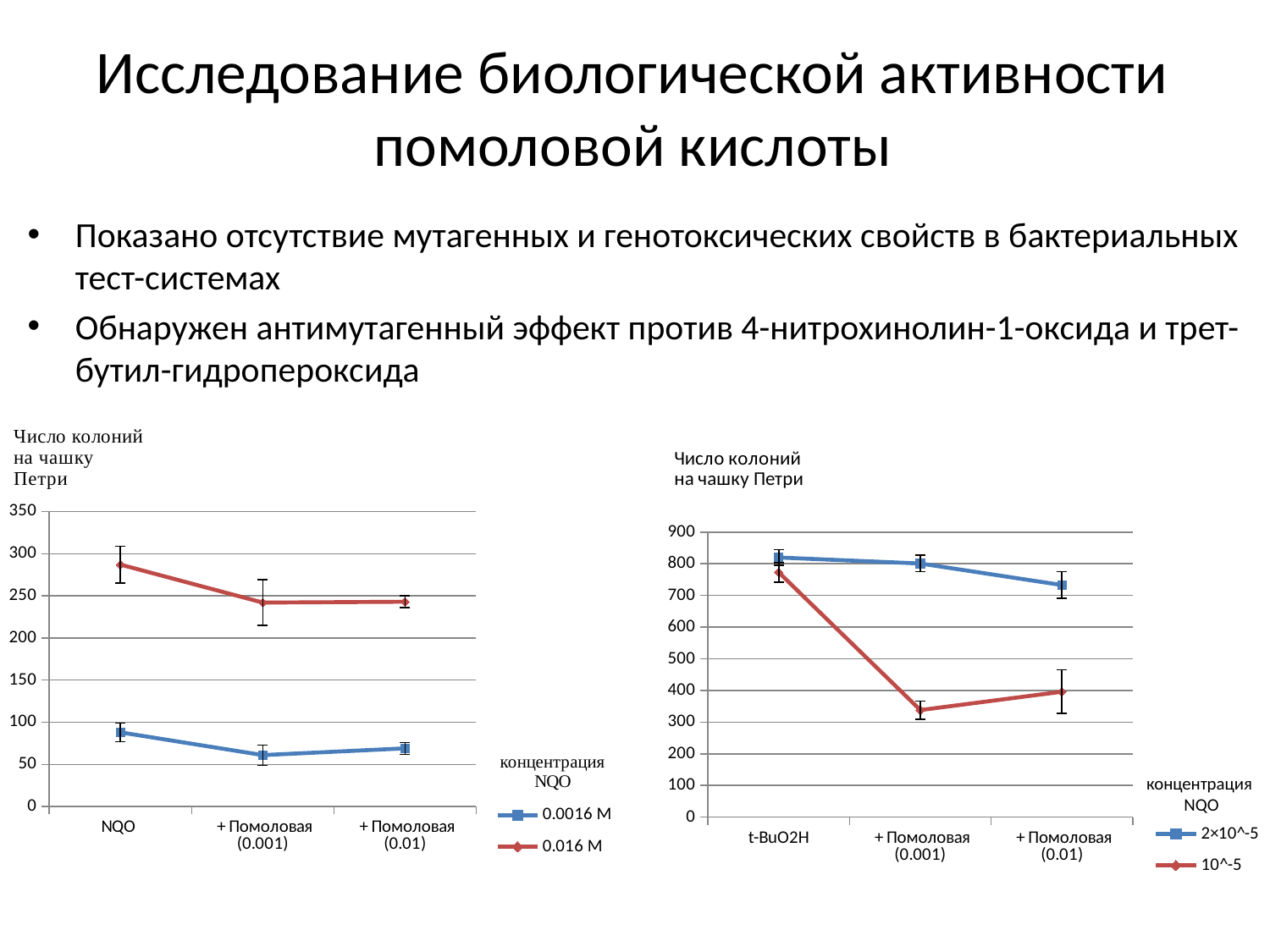
How many categories are on the x axis of the left chart? 3 What is the legend title of the right chart? концентрация NQO What kind of chart is the left chart on the slide? line chart How many series does the legend of the right chart list? 2 In the right chart, is the value of the 2×10^-5 series at t-BuO2H greater or less than 700? greater In the right chart, is the value of the 10^-5 series at + Помоловая (0.001) greater or less than 400? less In the right chart, does the 2×10^-5 series rise or fall from t-BuO2H to + Помоловая (0.01)? fall In the left chart, at NQO, which series has the larger value: 0.0016 M or 0.016 M? 0.016 M In the left chart, is the value of the 0.016 M series at NQO greater or less than 250? greater In the right chart, at which category is the 10^-5 series lowest? + Помоловая (0.001) In the left chart, at which category is the 0.016 M series highest? NQO